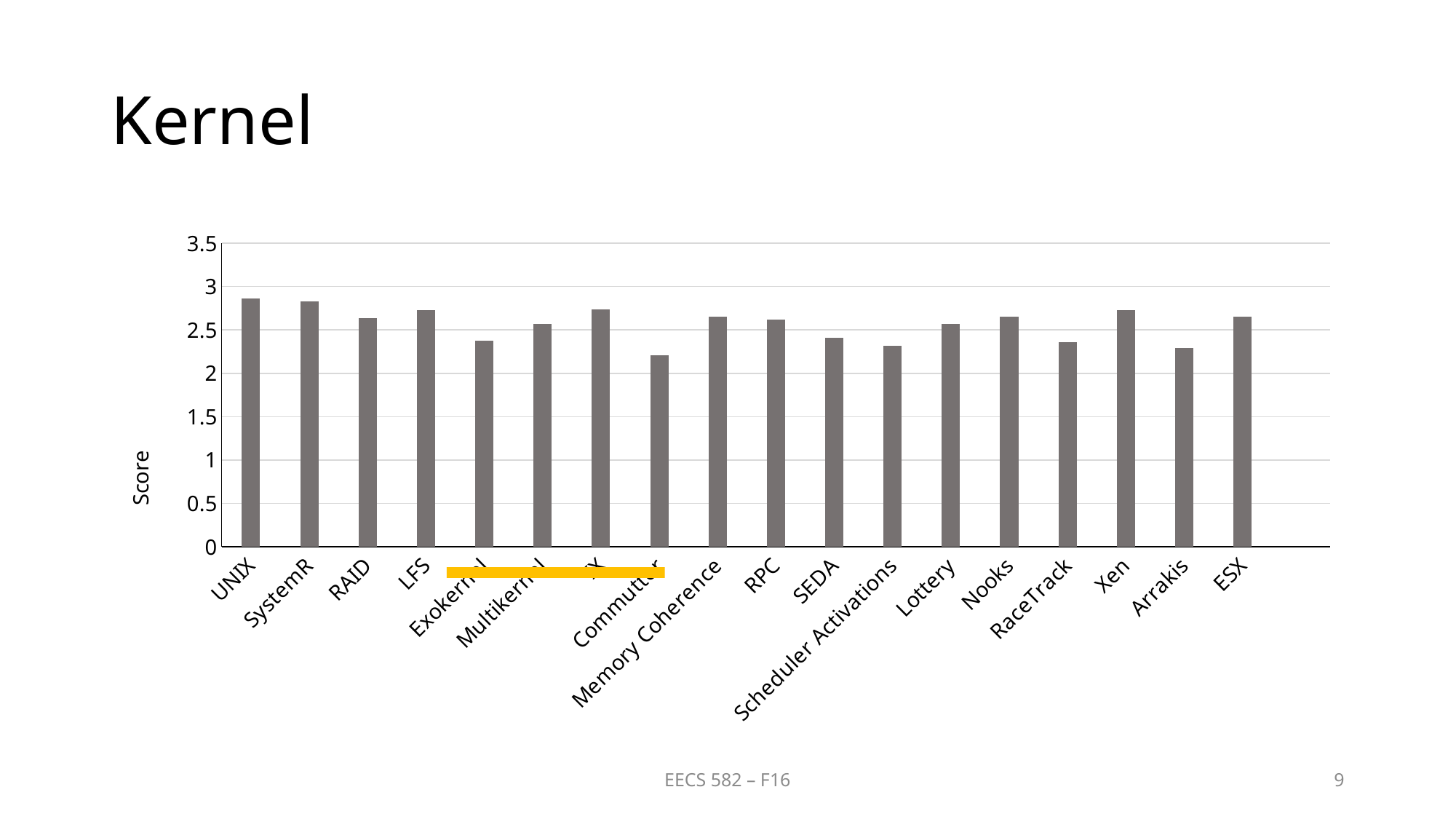
Is the value for UNIX greater or less than 2.5? greater Which has the larger value, Xen or Arrakis? Xen Which has the larger value, UNIX or Commuter? UNIX How many bars (categories) are plotted in the chart? 18 What is the title of the slide containing the chart? Kernel Is the value for LFS greater or less than 2.5? greater Is the value for Arrakis greater or less than 2.5? less What kind of chart is shown on the slide? bar chart What is the label on the vertical axis of the chart? Score